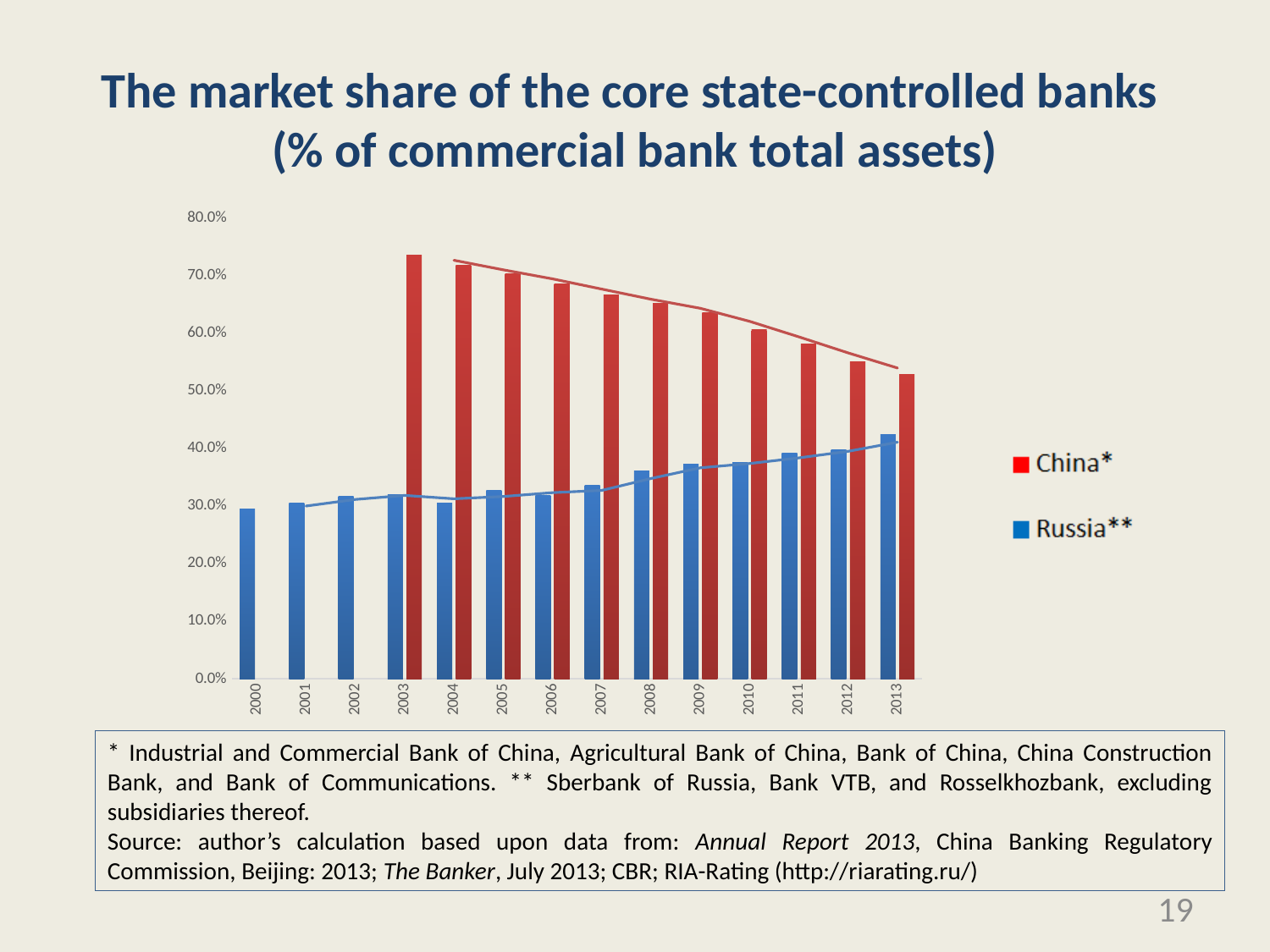
In which year is the value for Russia** highest? 2013 What kind of chart is shown on the slide? Bar chart Is the value for Russia** in 2013 greater or less than 40.0%? greater How many series does the legend list? 2 How many years are shown on the x axis? 14 Is the value for China* in 2003 greater or less than 70.0%? greater In which year is the value for China* highest? 2003 In 2013, which series has the larger value, China* or Russia**? China* Which two series are listed in the legend? China* and Russia** In which year is the value for China* lowest? 2013 Do the values for China* rise or fall from 2003 to 2013? Fall Do the values for Russia** rise or fall from 2004 to 2013? Rise